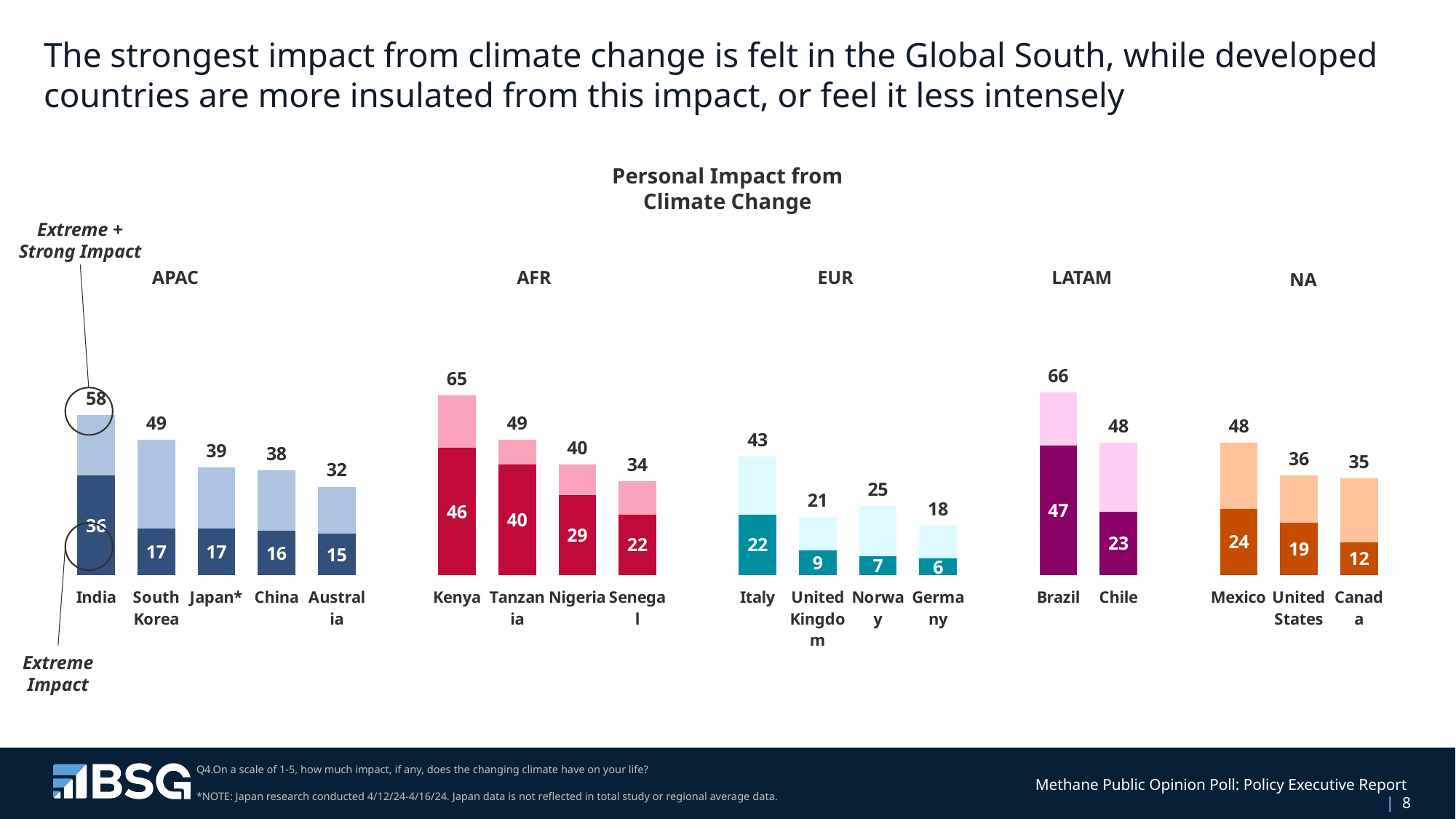
What is the title of the chart? Personal Impact from Climate Change What is the Extreme + Strong Impact value for Kenya? 65 Which has a higher Extreme Impact value, Mexico or Chile? Mexico How many countries are shown in the EUR group? 4 What kind of chart is shown on the slide? Stacked bar chart What is the Extreme Impact value for Brazil? 47 What is the Extreme Impact value for Germany? 6 Which country has the highest Extreme + Strong Impact value? Brazil Which country has the lowest Extreme + Strong Impact value? Germany What is the difference between the Extreme + Strong Impact values for Kenya and Senegal? 31 How many countries are shown in the chart in total? 18 Which regional groups are shown in the chart? APAC, AFR, EUR, LATAM, NA